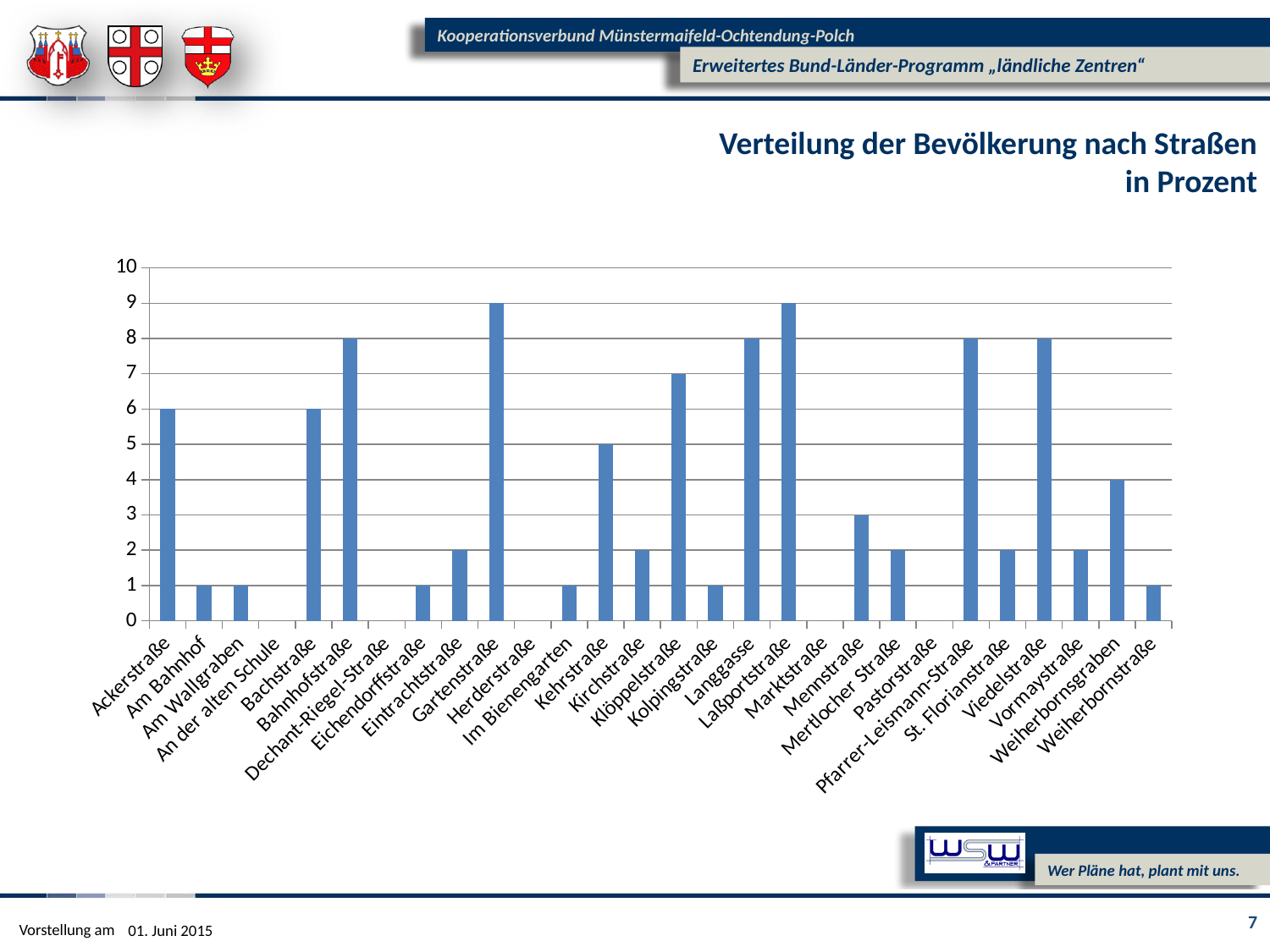
What is the value for Klöppelstraße? 7 What is the difference between the values for Bahnhofstraße and Eintrachtstraße? 6 How many street categories are shown on the x axis? 28 What is the highest value reached by any bar in the chart? 9 What kind of chart is shown on the slide? bar chart What is the value for Weiherbornsgraben? 4 Which has the larger value, Langgasse or Kehrstraße? Langgasse What is the value for Mennstraße? 3 What is the value for Kehrstraße? 5 What is the value for Gartenstraße? 9 Is the value for Laßportstraße greater or less than 5? greater What is the title of the chart? Verteilung der Bevölkerung nach Straßen in Prozent